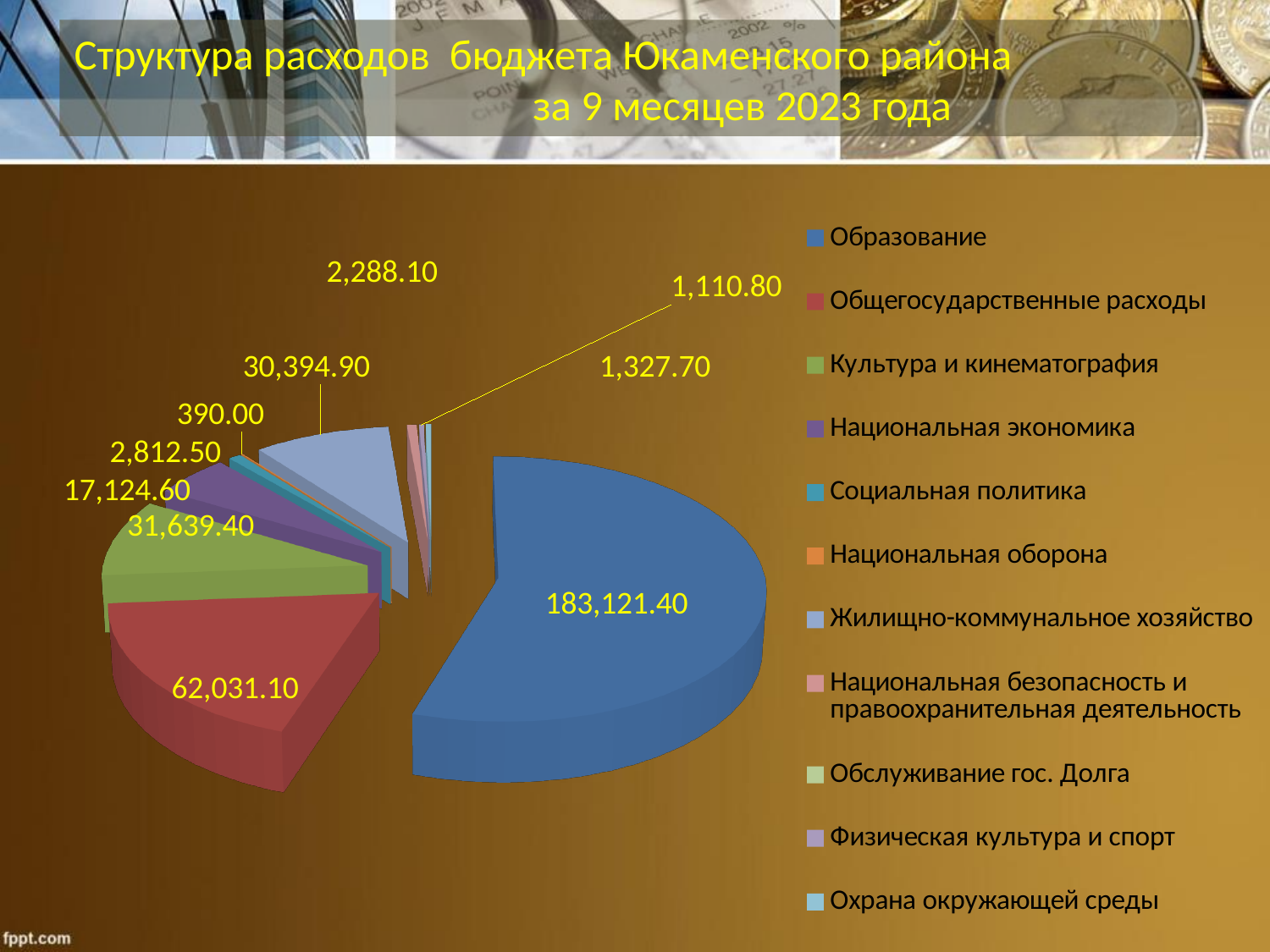
How many categories does the legend list? 11 What is the value for Национальная экономика? 17,124.60 What is the difference between the values for Образование and Общегосударственные расходы? 121,090.30 Which is larger: Культура и кинематография or Жилищно-коммунальное хозяйство? Культура и кинематография What is the value for Образование? 183,121.40 Which category has the largest share of the pie? Образование What is the value for Жилищно-коммунальное хозяйство? 30,394.90 What is the value for Культура и кинематография? 31,639.40 What is the value for Общегосударственные расходы? 62,031.10 What type of chart is shown on the slide? Pie chart What is the value for Национальная оборона? 390.00 What is the title of the slide? Структура расходов бюджета Юкаменского района за 9 месяцев 2023 года